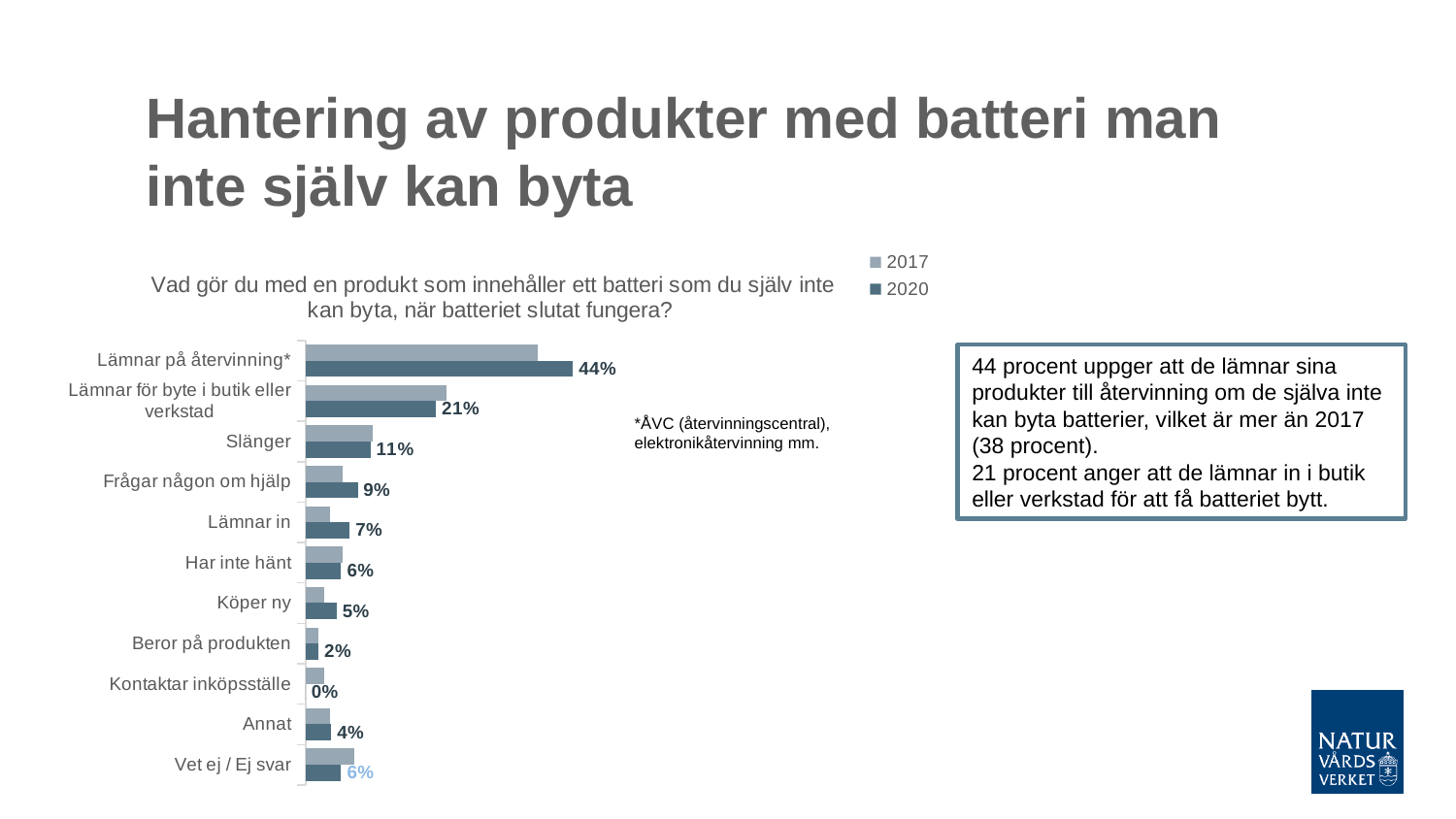
What kind of chart is shown on the slide? Bar chart Which category has the highest 2020 value? Lämnar på återvinning* What is the 2020 value for "Lämnar på återvinning*"? 44% What is the 2020 value for "Slänger"? 11% What is the 2020 value for "Kontaktar inköpsställe"? 0% What is the difference between the 2020 values for "Lämnar på återvinning*" and "Lämnar för byte i butik eller verkstad"? 23% Which category has the lowest 2020 value? Kontaktar inköpsställe Which has a larger 2020 value, "Frågar någon om hjälp" or "Köper ny"? Frågar någon om hjälp What is the 2020 value for "Lämnar för byte i butik eller verkstad"? 21% How many series does the legend list? 2 Which two years are listed in the chart legend? 2017 and 2020 How many categories are shown in the chart? 11